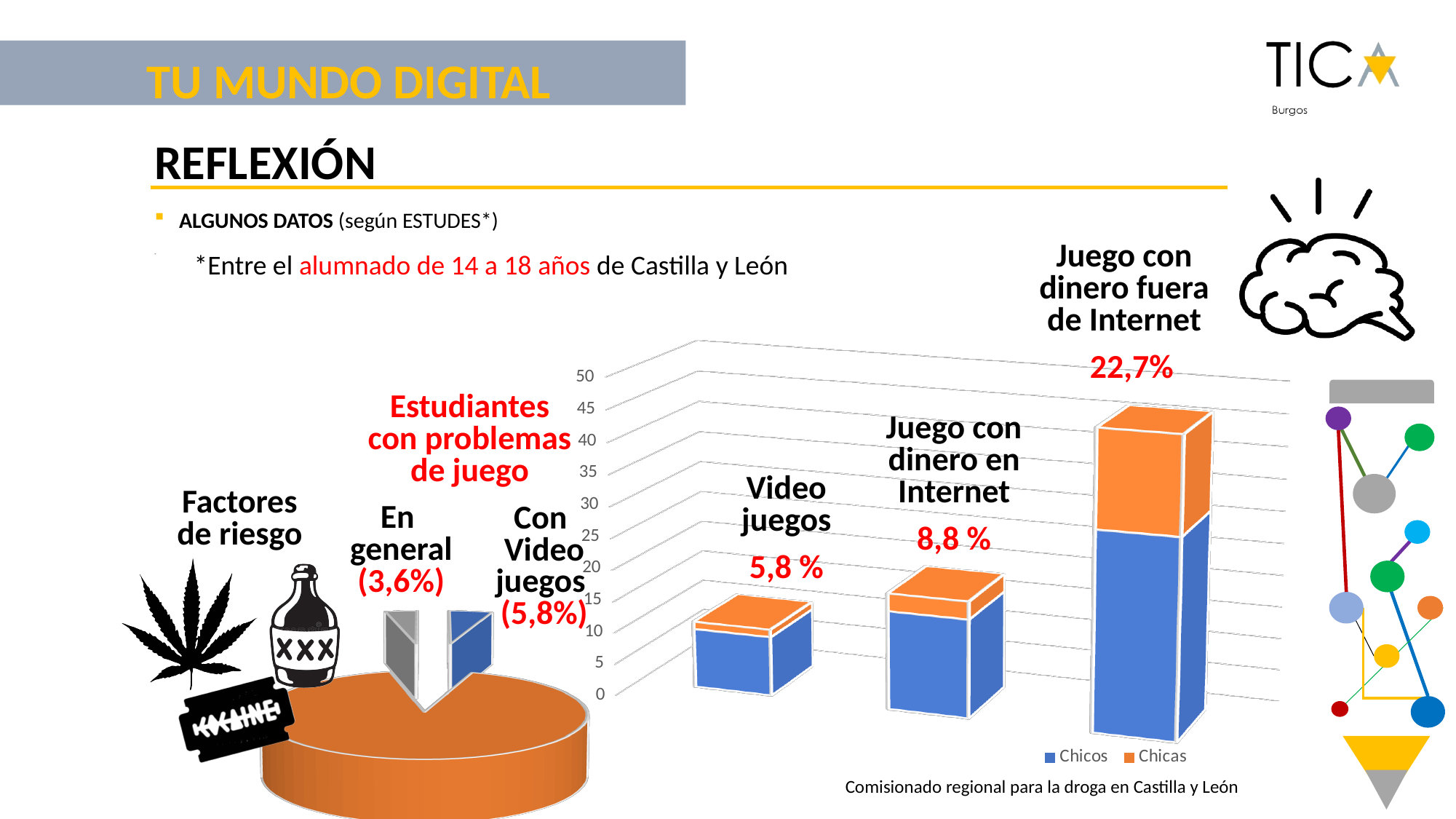
In the bar chart on the right, do the values rise or fall from left to right across the categories? rise In the bar chart on the right, what value is shown for Juego con dinero fuera de Internet? 22,7% In the bar chart on the right, which category has the lowest value? Video juegos In the bar chart on the right, what value is shown for Video juegos? 5,8 % In the bar chart on the right, what value is shown for Juego con dinero en Internet? 8,8 % In the pie chart on the left (Estudiantes con problemas de juego), what value is shown for En general? 3,6% In the bar chart on the right, how many series does the legend list? 2 In the bar chart on the right, how many categories (bars) are shown? 3 In the bar chart on the right, what are the two legend entries? Chicos, Chicas In the bar chart on the right, which category has the highest value? Juego con dinero fuera de Internet In the bar chart on the right, which is larger: Juego con dinero en Internet or Video juegos? Juego con dinero en Internet What kind of chart is the chart on the right of the slide, with the Chicos/Chicas legend? bar chart